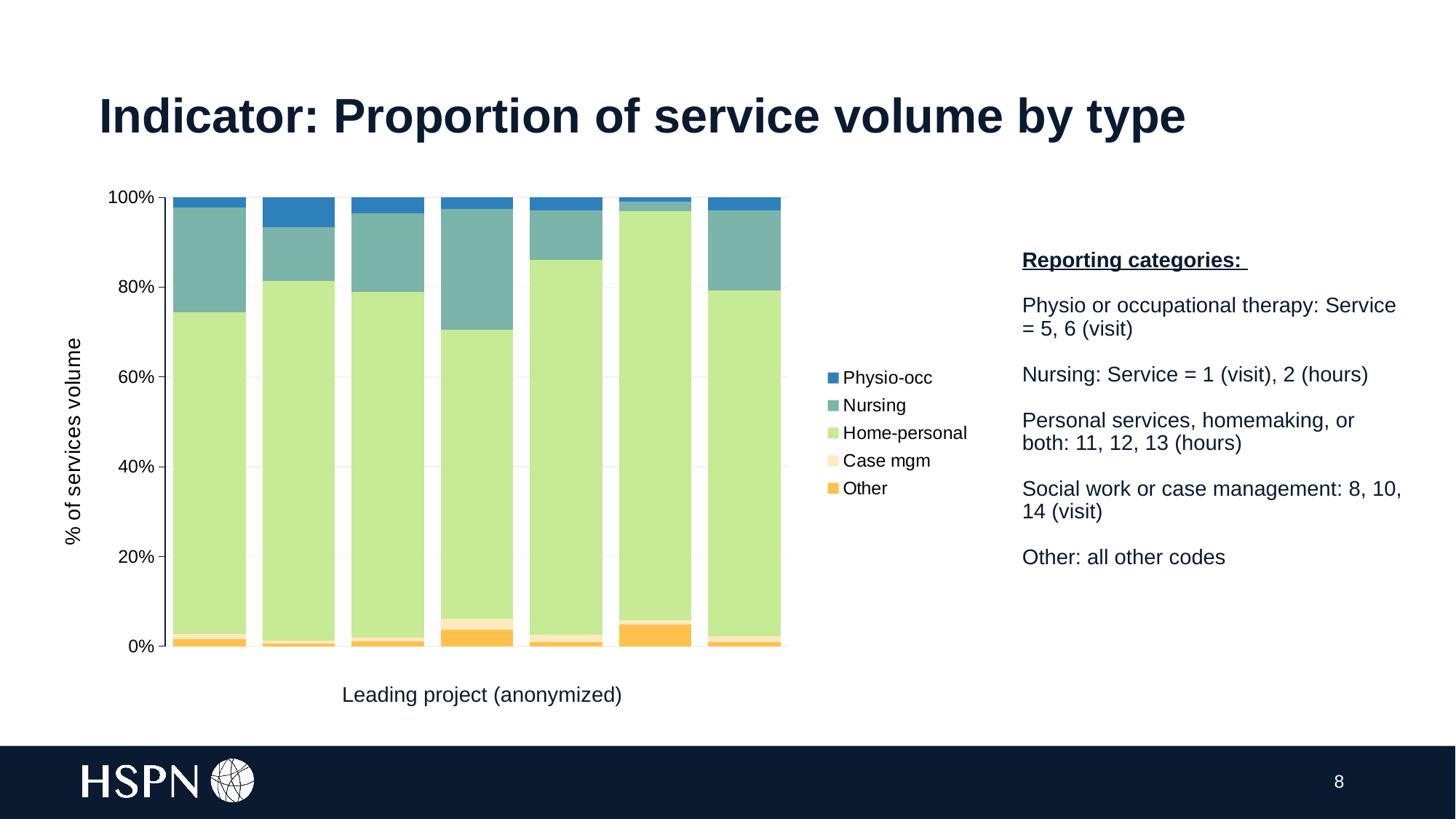
What is the title of the chart's y axis? % of services volume In the fourth bar from the left, is the top of the Home-personal segment greater or less than 80%? less What kind of chart is shown on the slide? Stacked bar chart What is the title of the chart's x axis? Leading project (anonymized) In the first bar from the left, is the top of the Home-personal segment greater or less than 80%? less What does each stacked bar total on the y axis? 100% How many bars (leading projects) are plotted in the chart? 7 Which bar has the smallest Nursing segment? The sixth bar from the left How many series does the chart legend list? 5 Which bar has the largest Home-personal segment? The sixth bar from the left In the fifth bar from the left, is the top of the Home-personal segment greater or less than 80%? greater Which bar has the largest Physio-occ segment? The second bar from the left